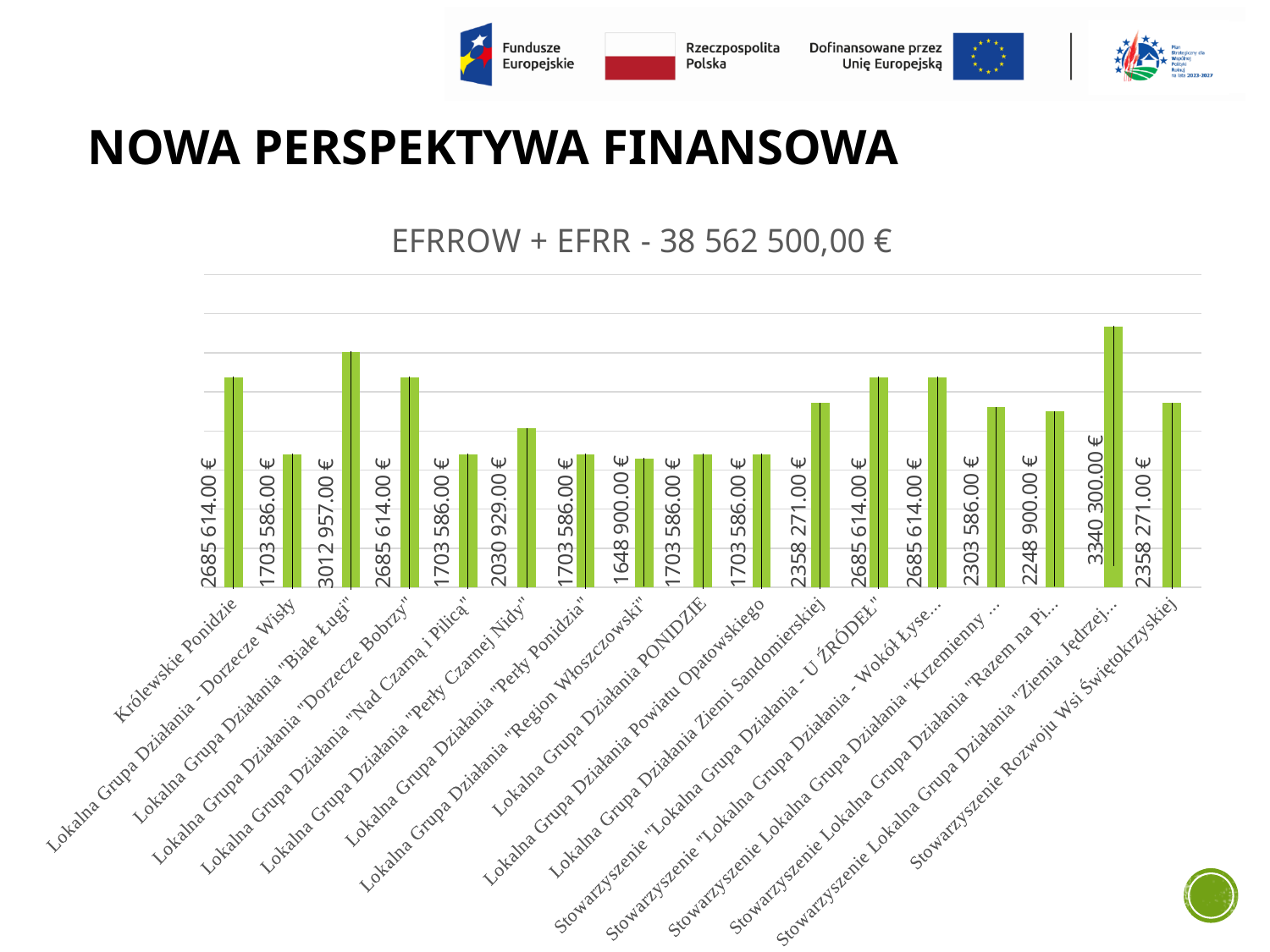
What is the value for Lokalna Grupa Działania "Białe Ługi"? 3012 957.00 € What is the value for Stowarzyszenie Rozwoju Wsi Świętokrzyskiej? 2358 271.00 € Which category has the highest value? Stowarzyszenie Lokalna Grupa Działania "Ziemia Jędrzej..." Which is larger: the value for Lokalna Grupa Działania Ziemi Sandomierskiej or for Stowarzyszenie Lokalna Grupa Działania "Razem na Pi..."? Lokalna Grupa Działania Ziemi Sandomierskiej What is the value for Lokalna Grupa Działania "Region Włoszczowski"? 1648 900.00 € What is the value for Królewskie Ponidzie? 2685 614.00 € Which category has the lowest value? Lokalna Grupa Działania "Region Włoszczowski" How many categories (bars) does the chart show? 17 What is the difference between the values for Lokalna Grupa Działania "Białe Ługi" and Królewskie Ponidzie? 327 343.00 € What kind of chart is shown on the slide? bar chart What is the title of the chart? EFRROW + EFRR - 38 562 500,00 € What is the value for Lokalna Grupa Działania "Perły Czarnej Nidy"? 2030 929.00 €